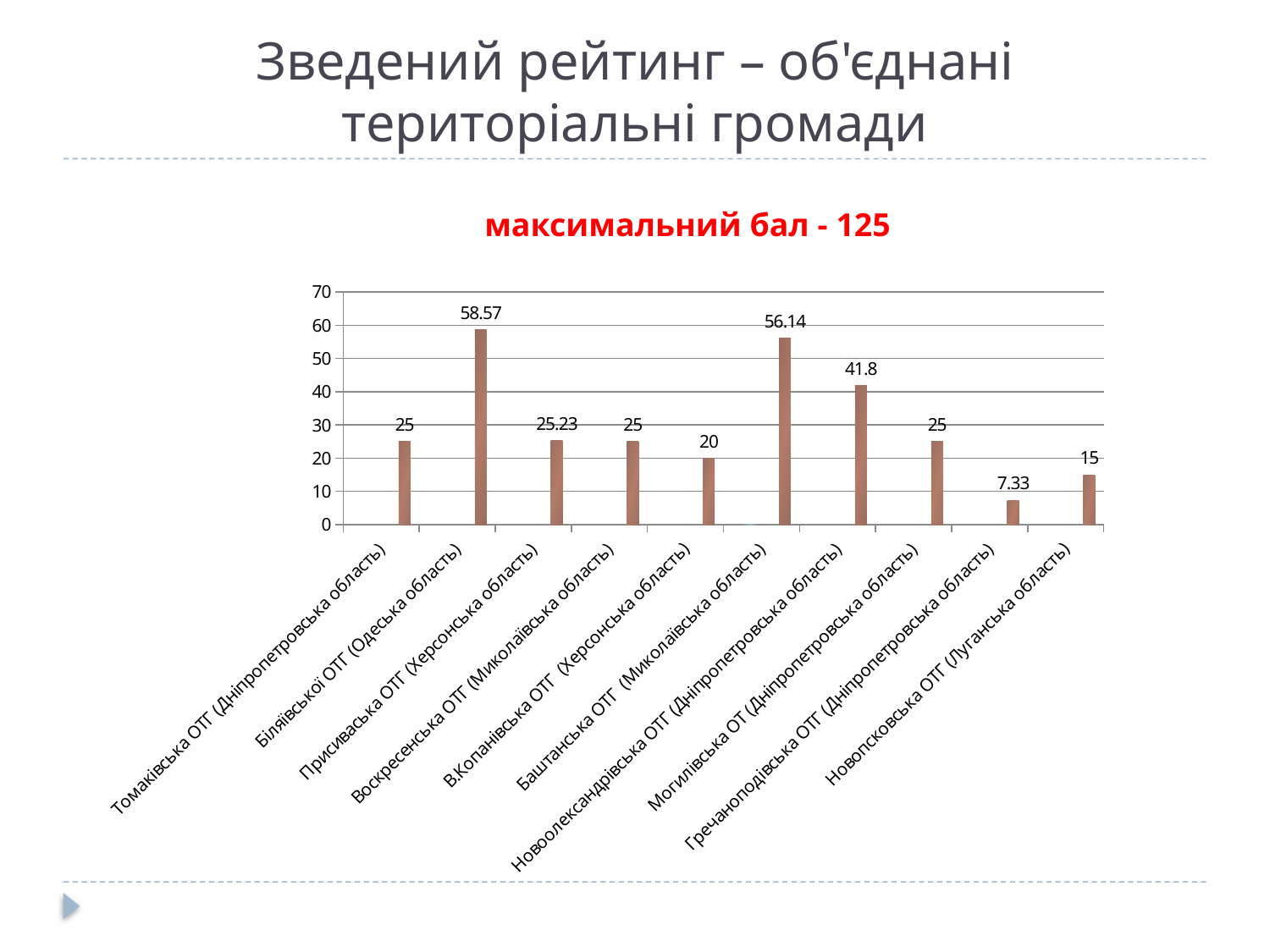
Is the value for Баштанська ОТГ (Миколаївська область) greater or less than 50? greater Which category has the highest value? Біляївської ОТГ (Одеська область) How many categories are shown on the chart? 10 What is the difference between the values for Біляївської ОТГ (Одеська область) and Баштанська ОТГ (Миколаївська область)? 2.43 What is the value for Новоолександрівська ОТГ (Дніпропетровська область)? 41.8 What is the value for Гречаноподівська ОТГ (Дніпропетровська область)? 7.33 What maximum score is stated above the chart? 125 What kind of chart is shown on the slide? bar chart Which is larger, the value for В.Копанівська ОТГ (Херсонська область) or the value for Новопсковська ОТГ (Луганська область)? В.Копанівська ОТГ (Херсонська область) What is the value for Біляївської ОТГ (Одеська область)? 58.57 Which category has the lowest value? Гречаноподівська ОТГ (Дніпропетровська область) What is the value for Новопсковська ОТГ (Луганська область)? 15